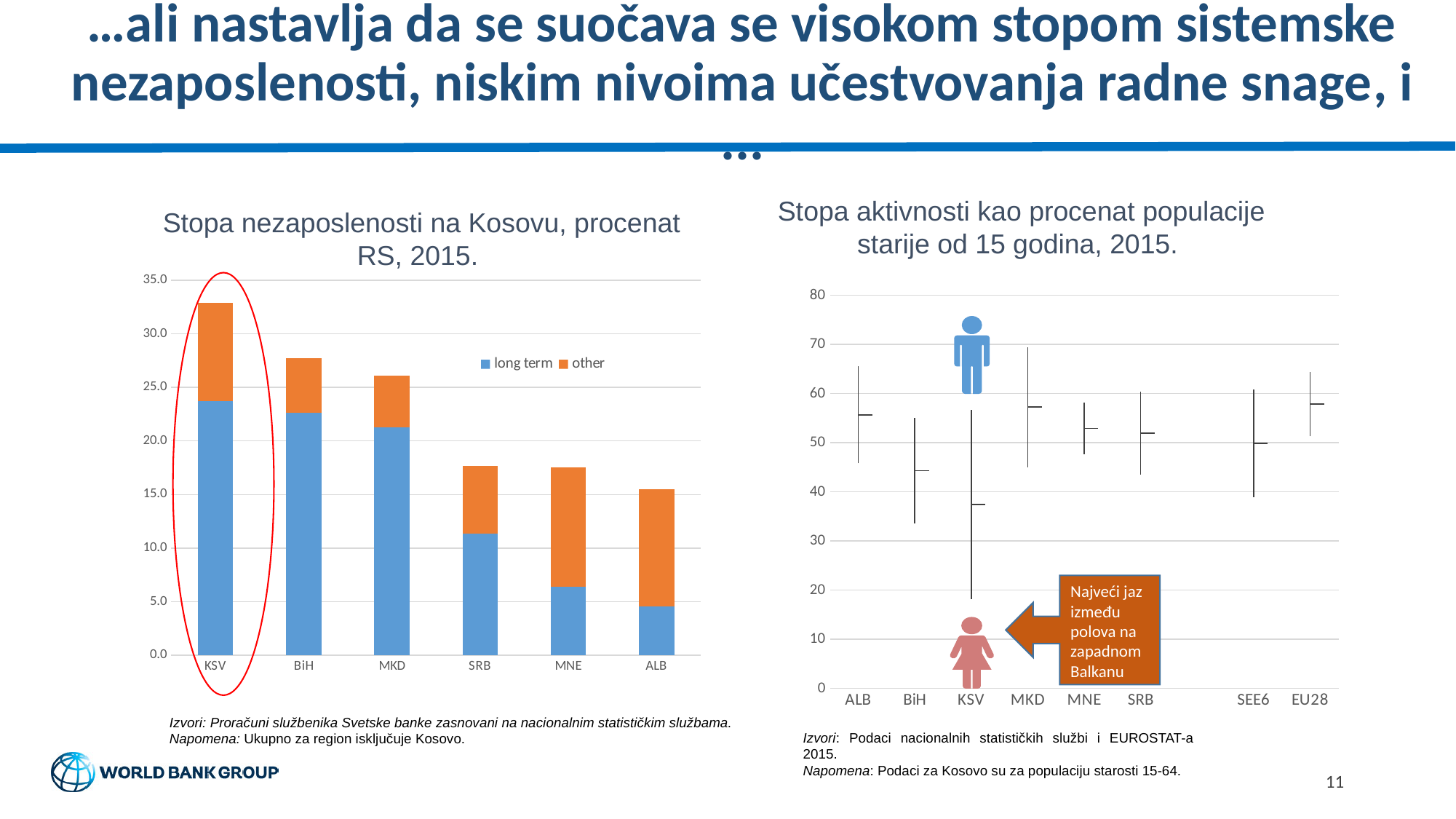
In the left chart, is the total value for KSV greater or less than 30.0? greater What kind of chart is the left chart, 'Stopa nezaposlenosti na Kosovu, procenat RS, 2015.'? Stacked bar chart How many categories are shown on the x axis of the right chart, 'Stopa aktivnosti kao procenat populacije starije od 15 godina, 2015.'? 8 In the left chart, which country has the smallest 'long term' segment? ALB How many countries are shown on the x axis of the left chart? 6 In the left chart, which country has the lowest total unemployment rate? ALB In the left chart, is the 'long term' value for MNE greater or less than 10.0? less In the right chart, which category has the widest gap between its highest and lowest points? KSV What are the two series named in the legend of the left chart? long term and other How many series does the legend of the left chart list? 2 In the left chart, which country has the highest total unemployment rate? KSV In the left chart, which is larger: the total for MKD or the total for SRB? MKD